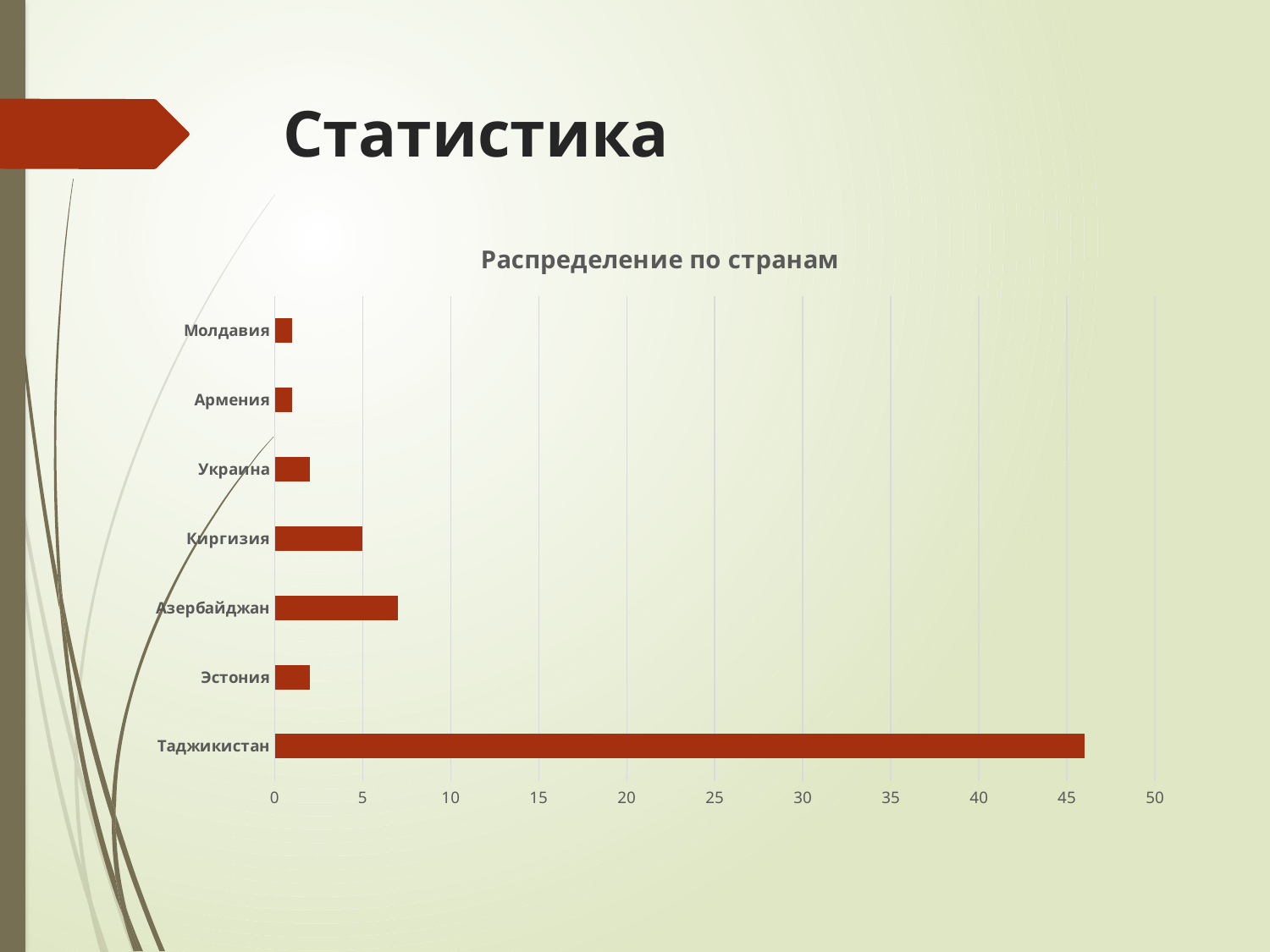
Is the value for Таджикистан greater or less than 40? greater What is the title of the chart? Распределение по странам How many countries are shown in the chart? 7 Is the value for Молдавия greater or less than 5? less Is the value for Азербайджан greater or less than 5? greater Which has a larger value, Азербайджан or Киргизия? Азербайджан What is the maximum value shown on the horizontal axis? 50 Which country has the highest value in the chart? Таджикистан What is the value for Киргизия? 5 Which has a larger value, Таджикистан or Азербайджан? Таджикистан What kind of chart is shown on the slide? bar chart